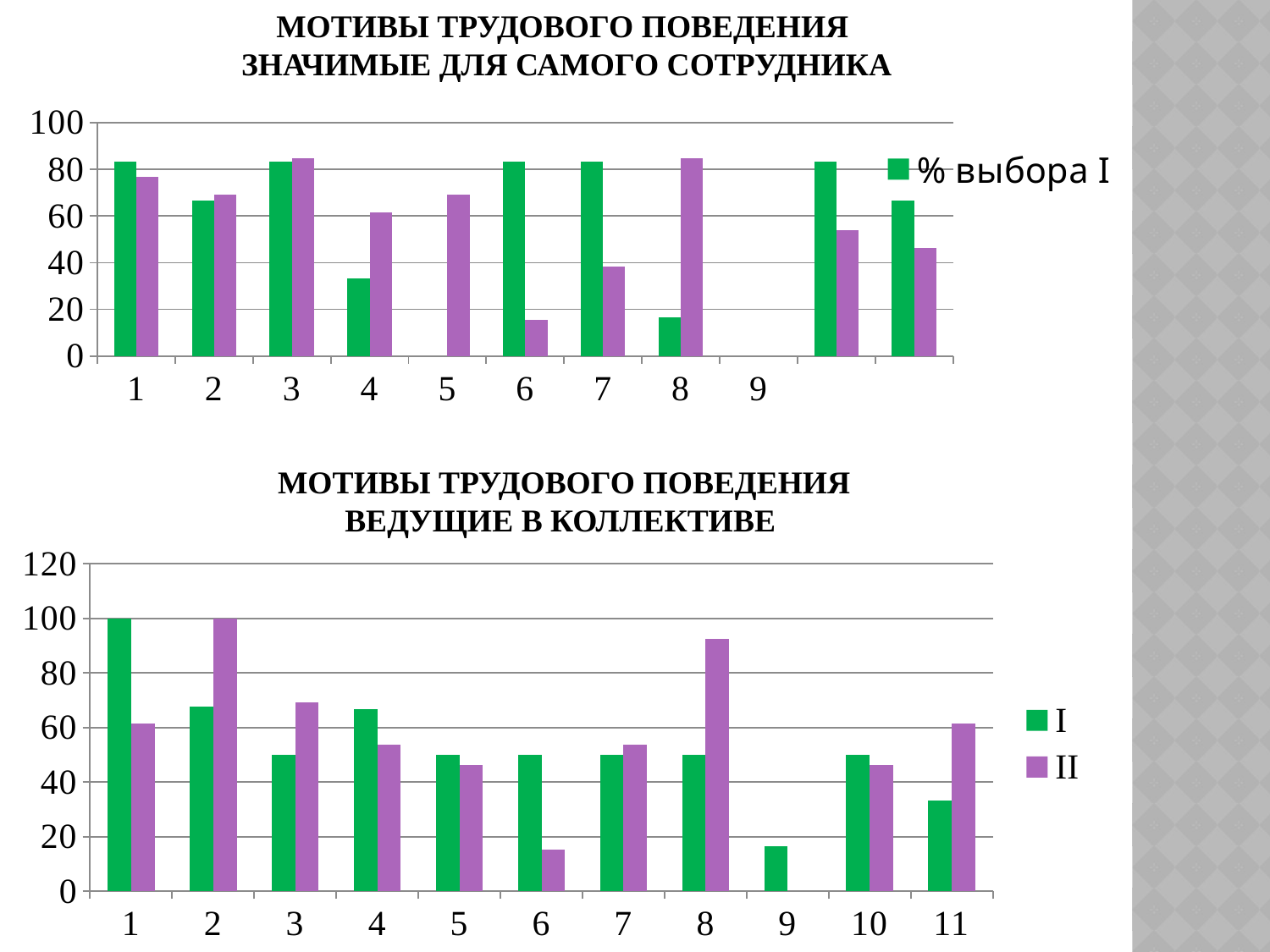
In the bottom chart, what is the value of series I for category 1? 100 What is the title of the top chart? МОТИВЫ ТРУДОВОГО ПОВЕДЕНИЯ ЗНАЧИМЫЕ ДЛЯ САМОГО СОТРУДНИКА In the bottom chart, what is the value of series II for category 2? 100 In the bottom chart, is the value of series II for category 8 greater or less than 80? greater In the bottom chart, is the value of series II for category 6 greater or less than 20? less How many series does the legend of the bottom chart list? 2 In the top chart, is the purple bar for category 6 greater or less than 20? less In the top chart, for category 4, which bar is taller, the green one or the purple one? the purple one In the bottom chart, for category 8, which series has the larger value, I or II? II What kind of chart is the bottom chart, 'МОТИВЫ ТРУДОВОГО ПОВЕДЕНИЯ ВЕДУЩИЕ В КОЛЛЕКТИВЕ'? bar chart In the bottom chart, which category has the lowest value for series I? 9 How many categories are shown on the x axis of the bottom chart? 11